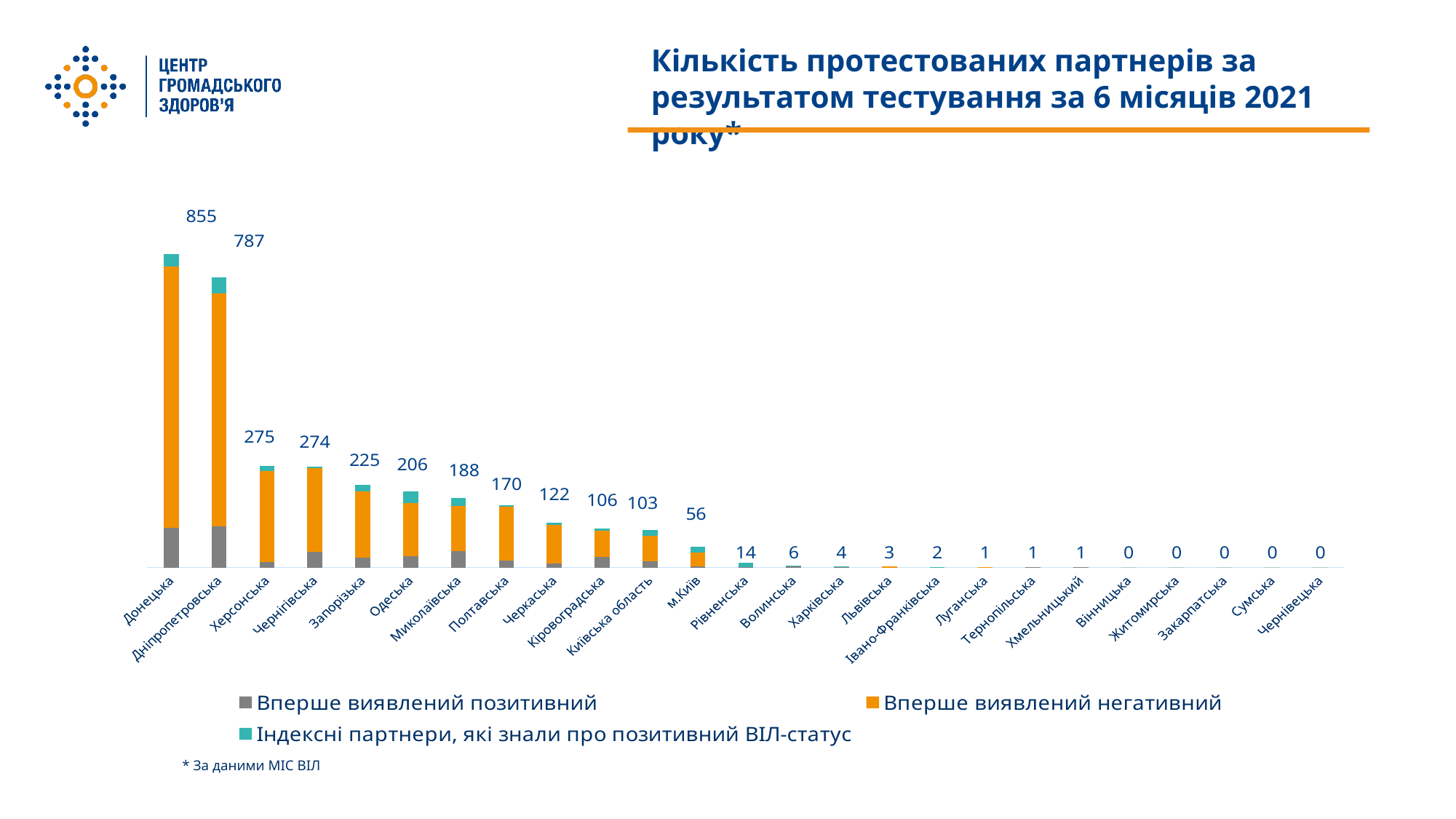
What is the total number of tested partners shown for м.Київ? 56 What kind of chart is shown on the slide? Stacked bar chart What is the total number of tested partners shown for Донецька? 855 What is the total number of tested partners shown for Херсонська? 275 Which legend entry is shown in orange? Вперше виявлений негативний What is the difference between the totals for Запорізька and Одеська? 19 How many regions (categories) are shown on the x axis? 25 Which has a larger total, Полтавська or Черкаська? Полтавська Do the total values rise or fall moving from left to right along the x axis? Fall Which region has the highest total number of tested partners? Донецька How many series does the legend list? 3 What is the difference between the totals for Донецька and Дніпропетровська? 68